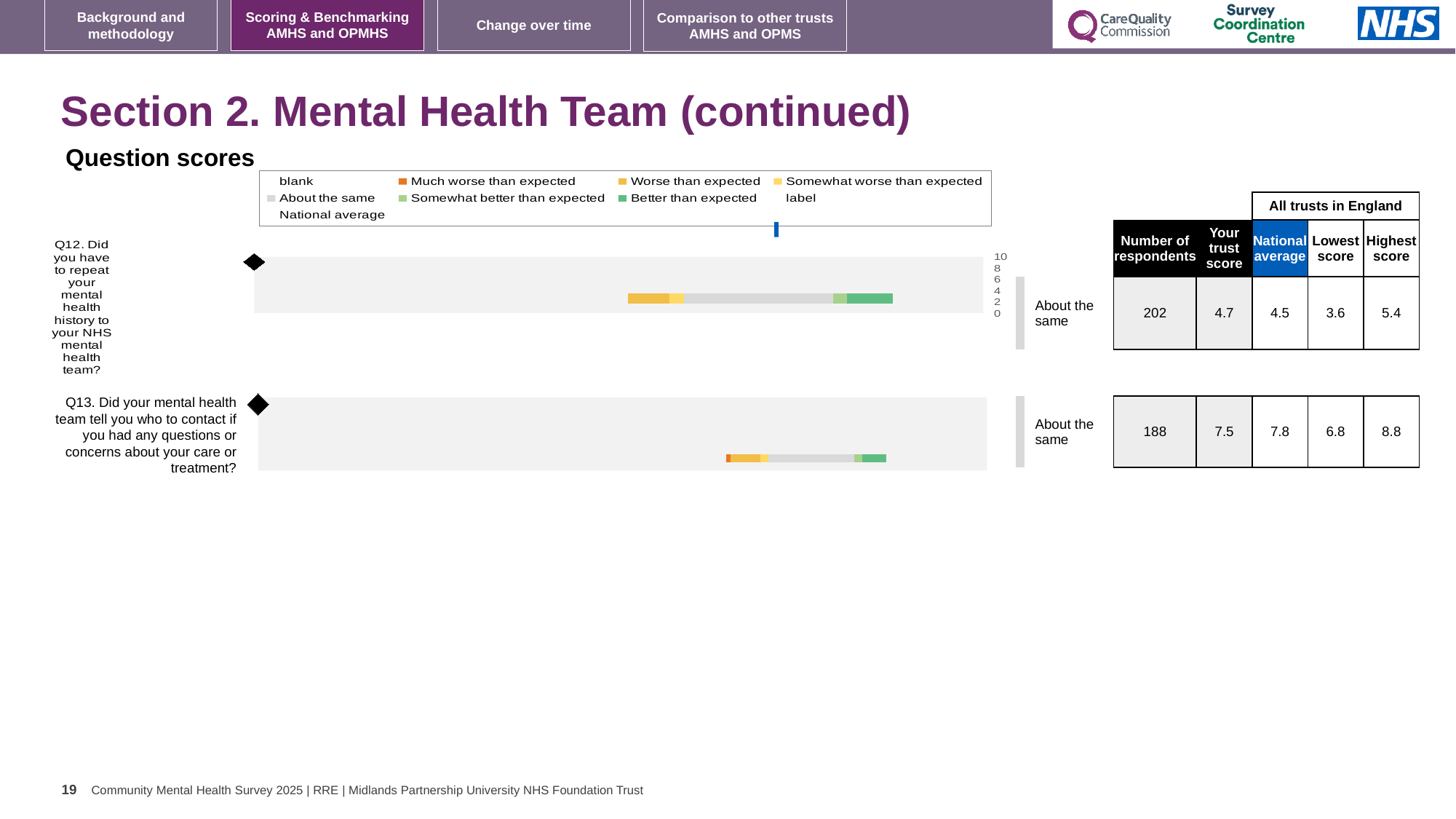
For Q13, which is larger: the trust score or the national average? National average What is the number of respondents for Q12? 202 What is the national average for Q13 (told who to contact)? 7.8 What is the lowest score among all trusts in England for Q12? 3.6 How many survey questions are plotted on the slide? 2 What benchmark category is shown for Q13? About the same What is the trust score for Q12 (repeating mental health history)? 4.7 Which legend entry is shown in dark green? Better than expected What kind of chart is used to show the question scores for Q12 and Q13? bar chart What is the highest score among all trusts in England for Q13? 8.8 What is the difference between the highest and lowest scores for Q12? 1.8 For Q12, is the trust score higher or lower than the national average? higher